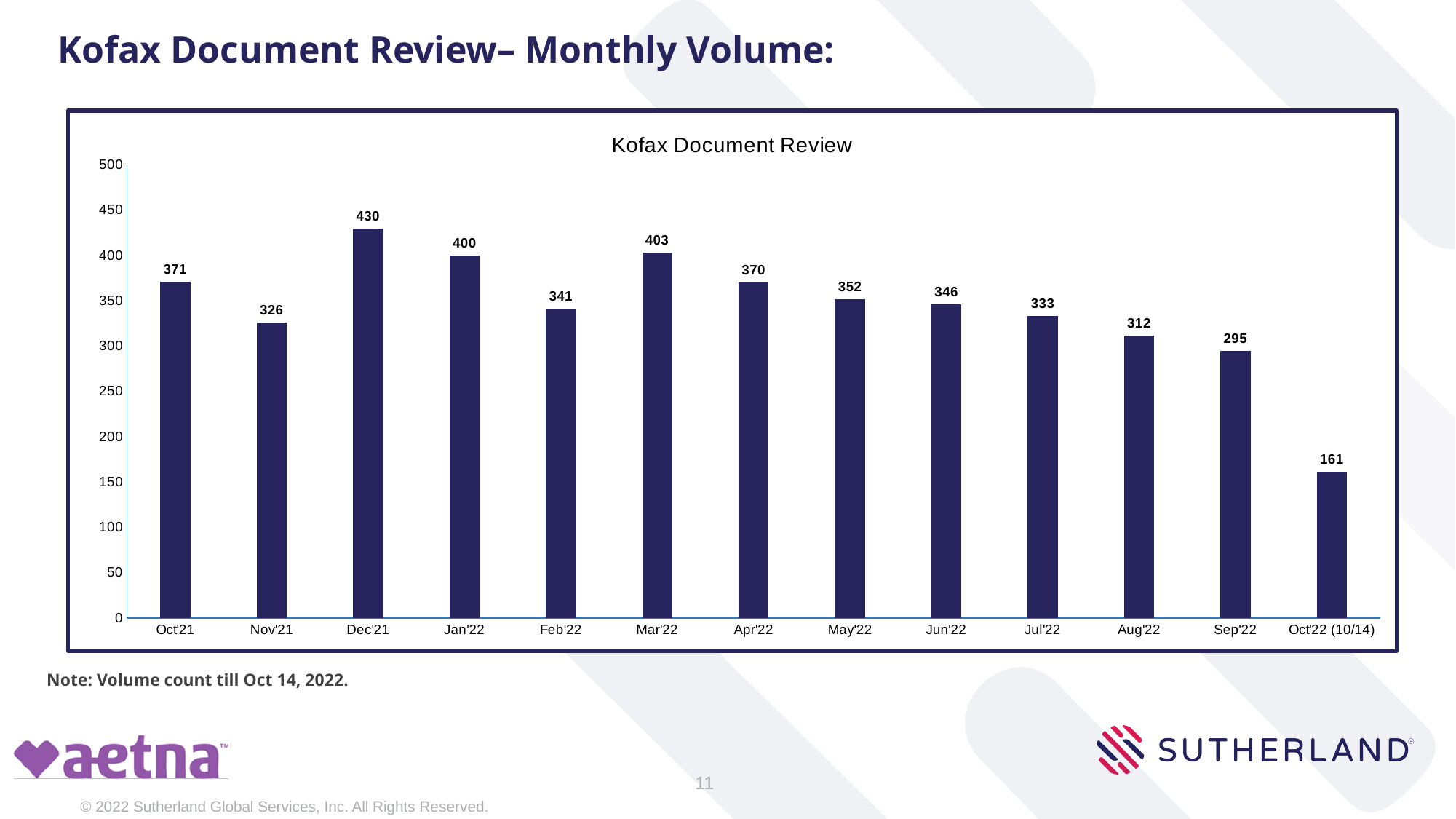
Do the values rise or fall from Apr'22 to Sep'22? fall What is the value for Oct'22 (10/14)? 161 What is the value for Dec'21? 430 What is the difference between the values for Dec'21 and Nov'21? 104 How many months are shown on the x axis? 13 Which is larger, the value for Jan'22 or the value for Mar'22? Mar'22 What kind of chart is shown? bar chart Which month has the lowest value? Oct'22 (10/14) What is the title of the chart? Kofax Document Review Is the value for Sep'22 greater or less than 300? less What is the value for Mar'22? 403 Which month has the highest value? Dec'21